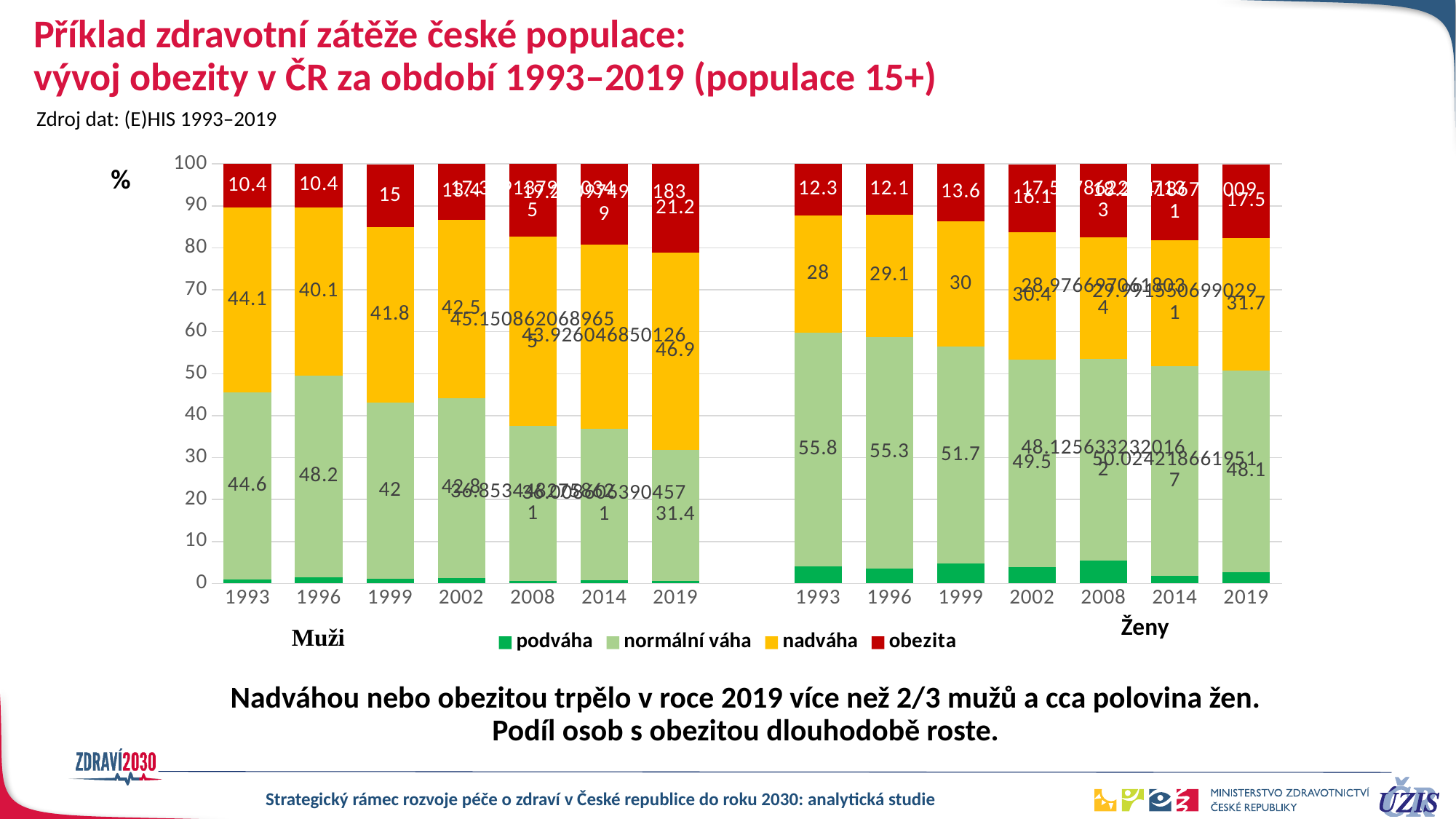
By how much did the obezita value for Muži increase from 1993 to 2019? 10.8 What kind of chart is shown on the slide? Stacked bar chart How many series does the legend list? 4 Which is larger in 1996: the normální váha value for Muži or for Ženy? Ženy What is the obezita value for Muži in 2019? 21.2 What is the normální váha value for Ženy in 1993? 55.8 What is the nadváha value for Ženy in 2019? 31.7 In which year is the obezita value for Muži the highest? 2019 How many years are shown for the Muži group? 7 What is the obezita value for Muži in 1993? 10.4 Does the obezita value for Ženy rise or fall from 1993 to 2019? Rises What is the obezita value for Ženy in 1999? 13.6